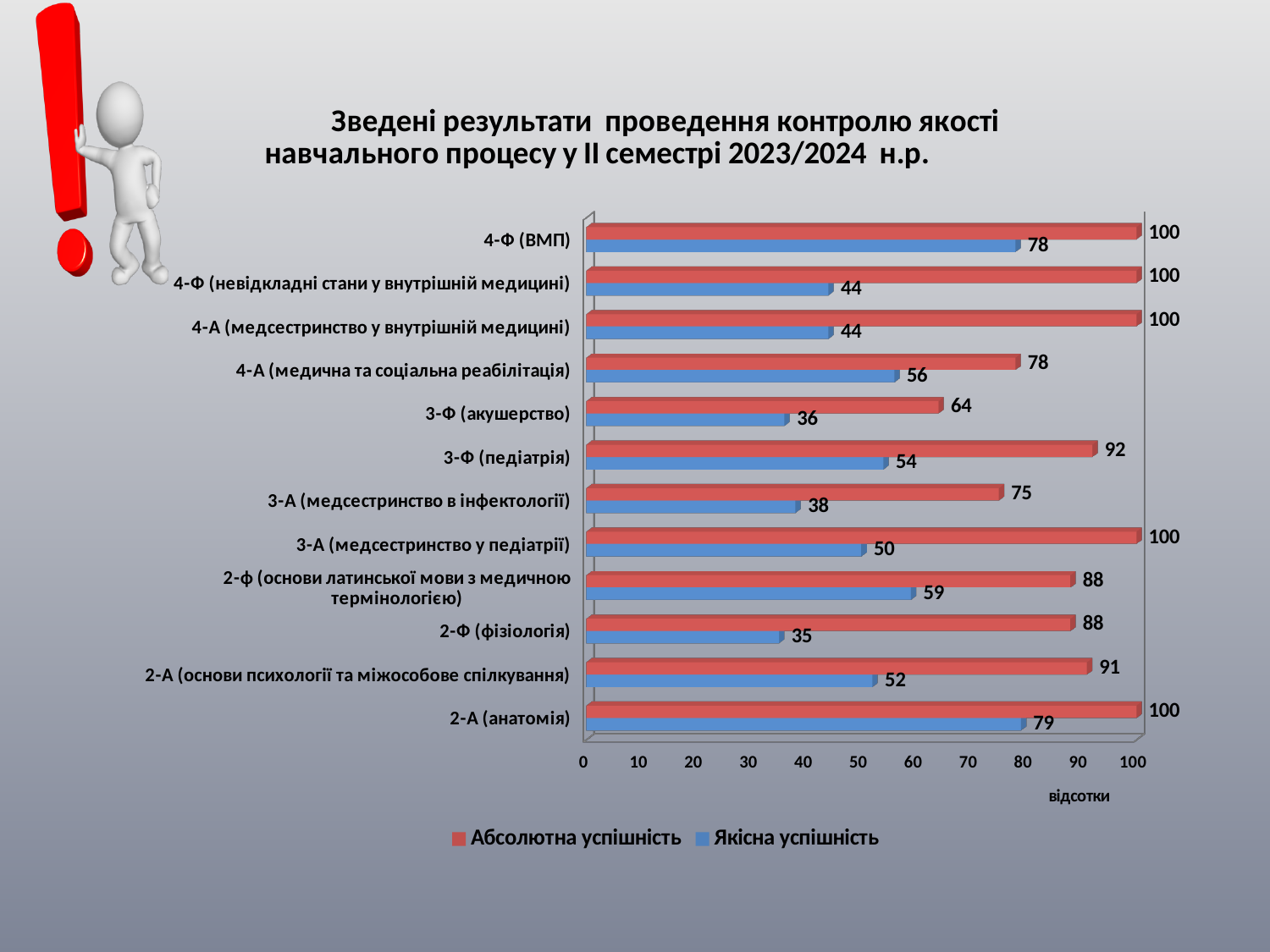
Which category has the lowest Абсолютна успішність value? 3-Ф (акушерство) Which is larger: the Якісна успішність value for 3-Ф (педіатрія) or for 3-А (медсестринство в інфектології)? 3-Ф (педіатрія) How many series does the legend list? 2 What label is shown on the horizontal axis of the chart? відсотки What kind of chart is shown on the slide? Bar chart Which category has the lowest Якісна успішність value? 2-Ф (фізіологія) What is the difference between the Абсолютна успішність and Якісна успішність values for 2-Ф (фізіологія)? 53 Which category has the highest Якісна успішність value? 2-А (анатомія) What is the Якісна успішність value for 2-А (анатомія)? 79 What is the Якісна успішність value for 3-Ф (акушерство)? 36 How many categories are shown on the chart? 12 What is the Абсолютна успішність value for 3-Ф (педіатрія)? 92